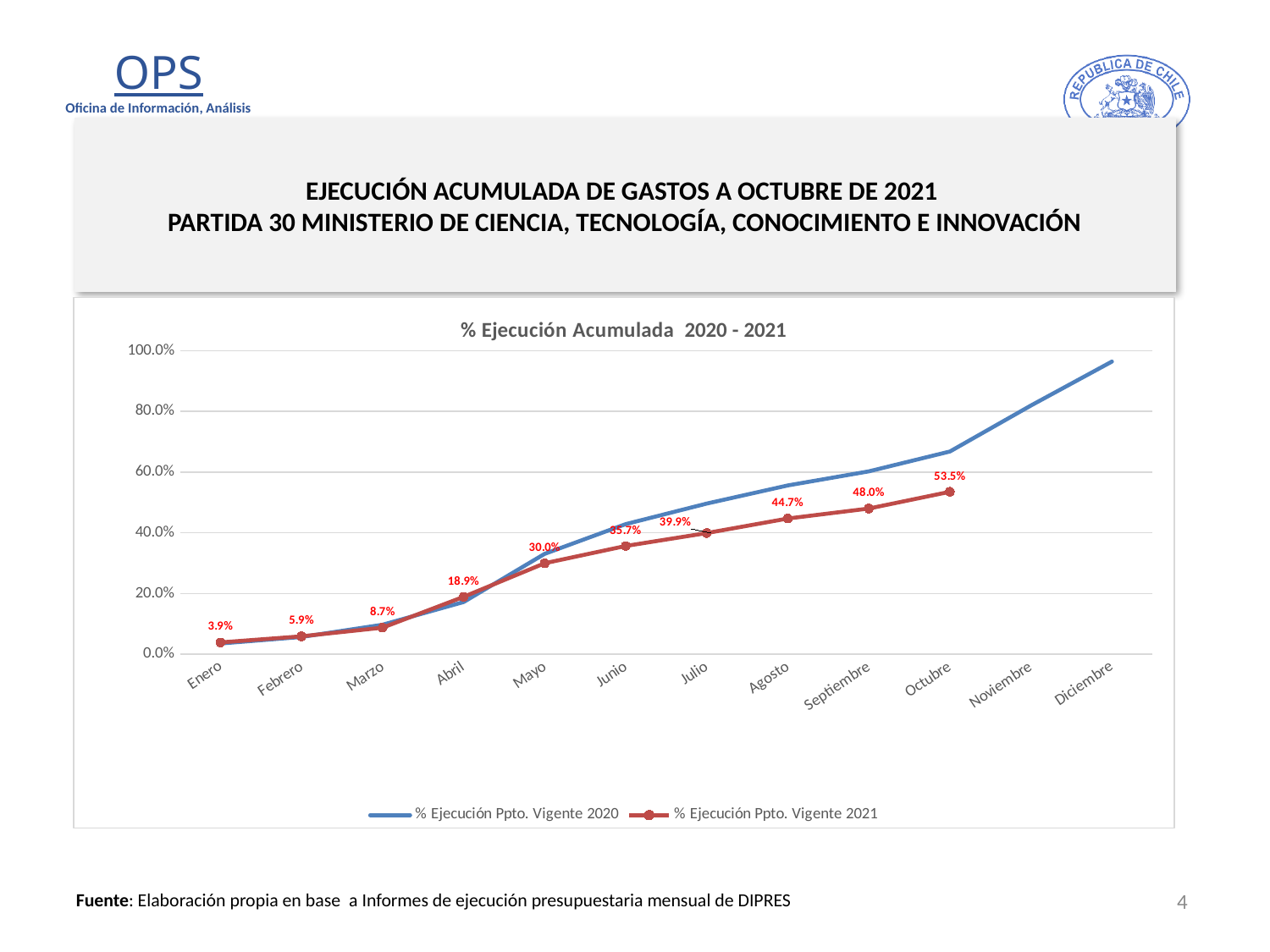
What is the % Ejecución Ppto. Vigente 2021 value for Mayo? 30.0% How many series does the legend list? 2 What is the % Ejecución Ppto. Vigente 2021 value for Octubre? 53.5% What is the difference between the 2021 values for Mayo and Abril? 11.1% Which month has the highest labelled value for % Ejecución Ppto. Vigente 2021? Octubre What kind of chart is shown on the slide? Line chart What is the % Ejecución Ppto. Vigente 2021 value for Agosto? 44.7% Is the % Ejecución Ppto. Vigente 2020 value for Diciembre greater or less than 80.0%? greater For Octubre, which series has the larger value, % Ejecución Ppto. Vigente 2020 or % Ejecución Ppto. Vigente 2021? % Ejecución Ppto. Vigente 2020 What is the % Ejecución Ppto. Vigente 2021 value for Enero? 3.9% Which month has the lowest labelled value for % Ejecución Ppto. Vigente 2021? Enero What is the difference between the 2021 values for Octubre and Septiembre? 5.5%